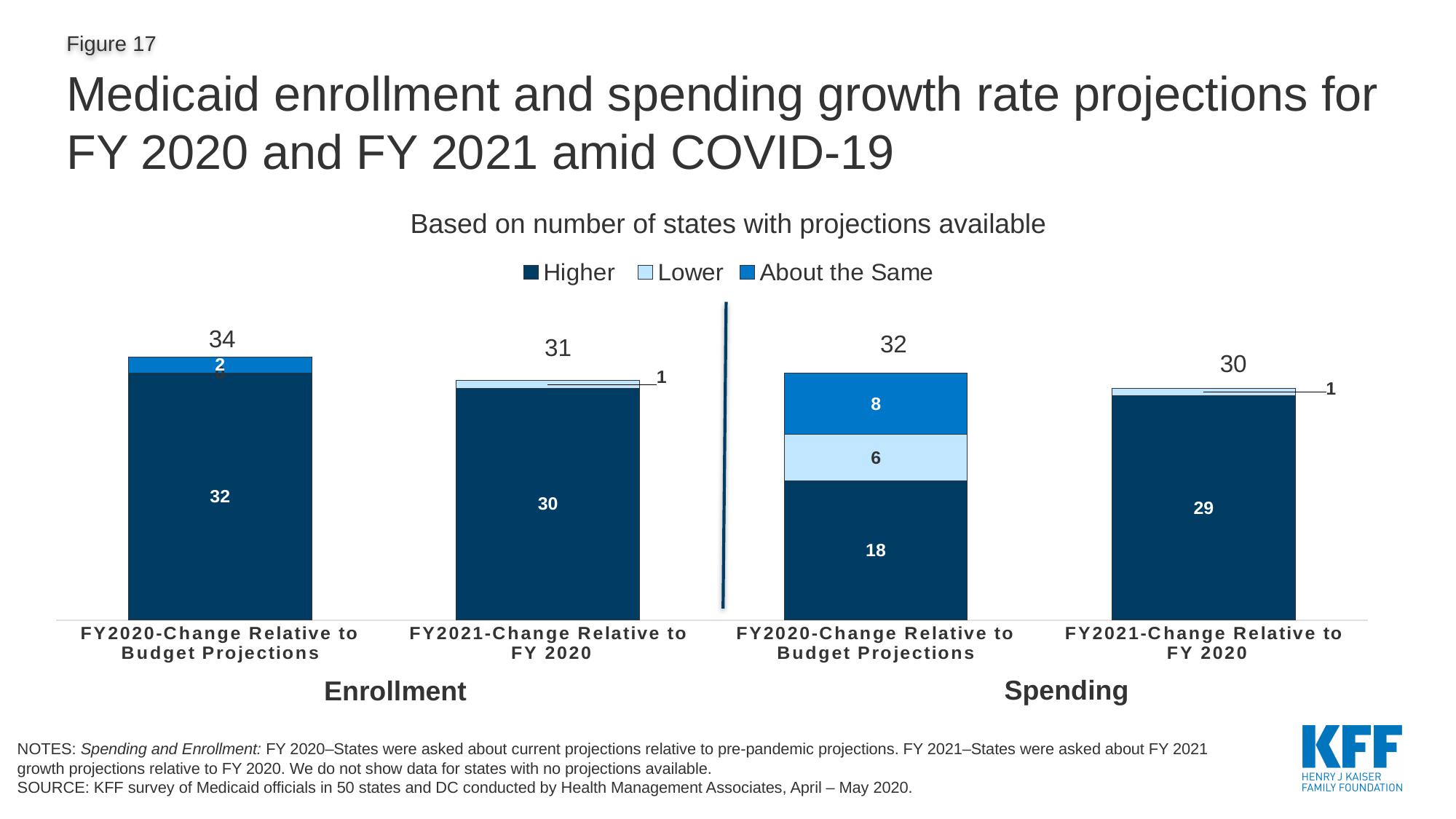
What is the 'About the Same' value for Spending, FY2020-Change Relative to Budget Projections? 8 What kind of chart is shown on the slide? Stacked bar chart What is the 'Higher' value for Enrollment, FY2020-Change Relative to Budget Projections? 32 How many series does the legend list? 3 What is the total of the stacked bar for Spending, FY2020-Change Relative to Budget Projections? 32 How many bars are plotted in the chart? 4 Which is larger: the 'Higher' value for Enrollment FY2021-Change Relative to FY 2020 or the 'Higher' value for Spending FY2021-Change Relative to FY 2020? Enrollment FY2021-Change Relative to FY 2020 What is the 'Lower' value for Spending, FY2020-Change Relative to Budget Projections? 6 What is the total of the stacked bar for Enrollment, FY2020-Change Relative to Budget Projections? 34 Which bar has the lowest total? Spending, FY2021-Change Relative to FY 2020 What is the difference between the 'Higher' values for Enrollment FY2020-Change Relative to Budget Projections and Spending FY2020-Change Relative to Budget Projections? 14 What is the 'Higher' value for Spending, FY2021-Change Relative to FY 2020? 29